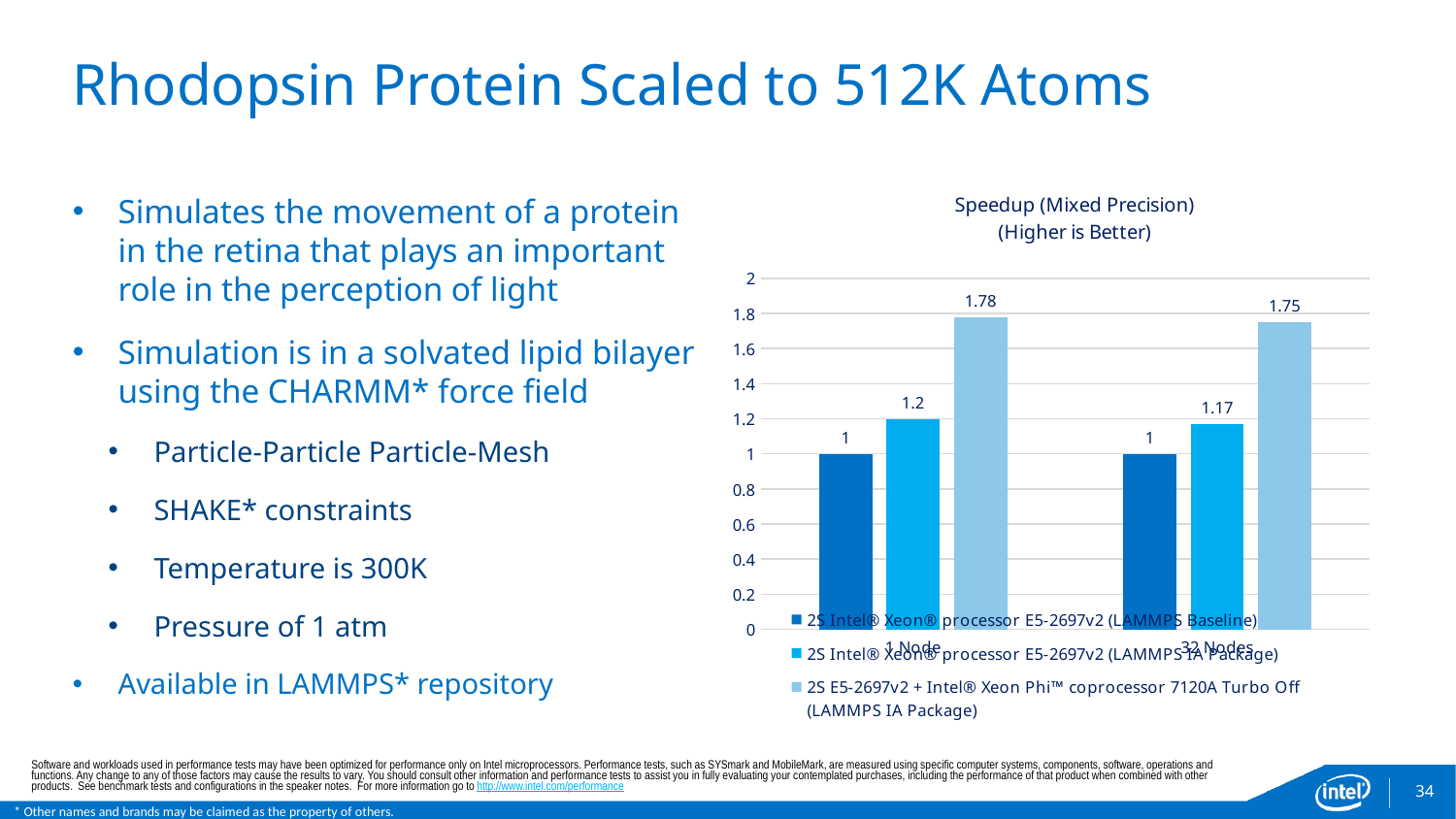
What is the speedup for the Xeon Phi coprocessor 7120A Turbo Off (LAMMPS IA Package) series at 32 Nodes? 1.75 Which series has the highest speedup at 1 Node? 2S E5-2697v2 + Intel® Xeon Phi™ coprocessor 7120A Turbo Off (LAMMPS IA Package) Is the Xeon Phi coprocessor speedup at 1 Node greater or less than 1.6? greater How many node-count categories are shown on the x axis? 2 What type of chart is shown on the slide? bar chart What is the speedup for the Xeon Phi coprocessor 7120A Turbo Off (LAMMPS IA Package) series at 1 Node? 1.78 What is the speedup for the 2S Intel Xeon processor E5-2697v2 (LAMMPS IA Package) series at 32 Nodes? 1.17 How many series does the chart legend list? 3 What is the difference between the Xeon Phi coprocessor speedup and the LAMMPS IA Package speedup at 32 Nodes? 0.58 What is the speedup for the 2S Intel Xeon processor E5-2697v2 (LAMMPS IA Package) series at 1 Node? 1.2 What is the speedup for the LAMMPS Baseline series at 32 Nodes? 1 What is the title of the chart? Speedup (Mixed Precision) (Higher is Better)